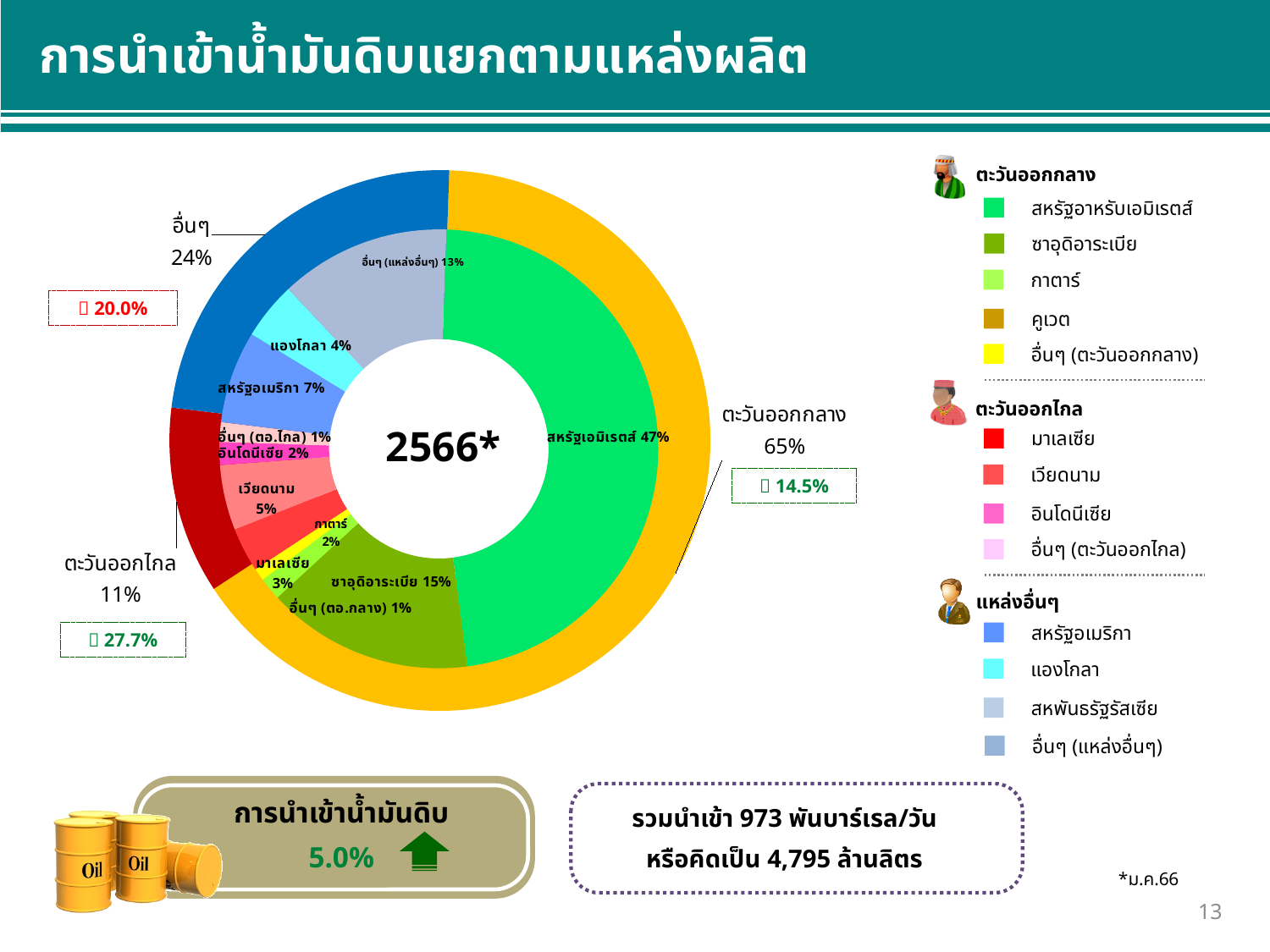
Which has a larger share of crude oil imports, แองโกลา (Angola) or มาเลเซีย (Malaysia)? แองโกลา (4%) What share of crude oil imports comes from ซาอุดิอาระเบีย (Saudi Arabia)? 15% What share of crude oil imports comes from สหรัฐอเมริกา (USA)? 7% What is the difference in share between สหรัฐเอมิเรตส์ (47%) and ซาอุดิอาระเบีย (15%)? 32 percentage points In the outer ring, what share of crude oil imports comes from ตะวันออกไกล (Far East)? 11% In the outer ring, what share of crude oil imports comes from ตะวันออกกลาง (Middle East)? 65% Which region in the outer ring has the largest share of crude oil imports? ตะวันออกกลาง (65%) Which region in the outer ring has the smallest share of crude oil imports? ตะวันออกไกล (11%) What kind of chart is used to show crude oil imports by source? Doughnut (pie) chart What share of crude oil imports comes from เวียดนาม (Vietnam)? 5% What share of crude oil imports comes from สหรัฐเอมิเรตส์ (UAE) in the inner ring of the doughnut chart? 47% What year label is shown in the centre of the doughnut chart? 2566*